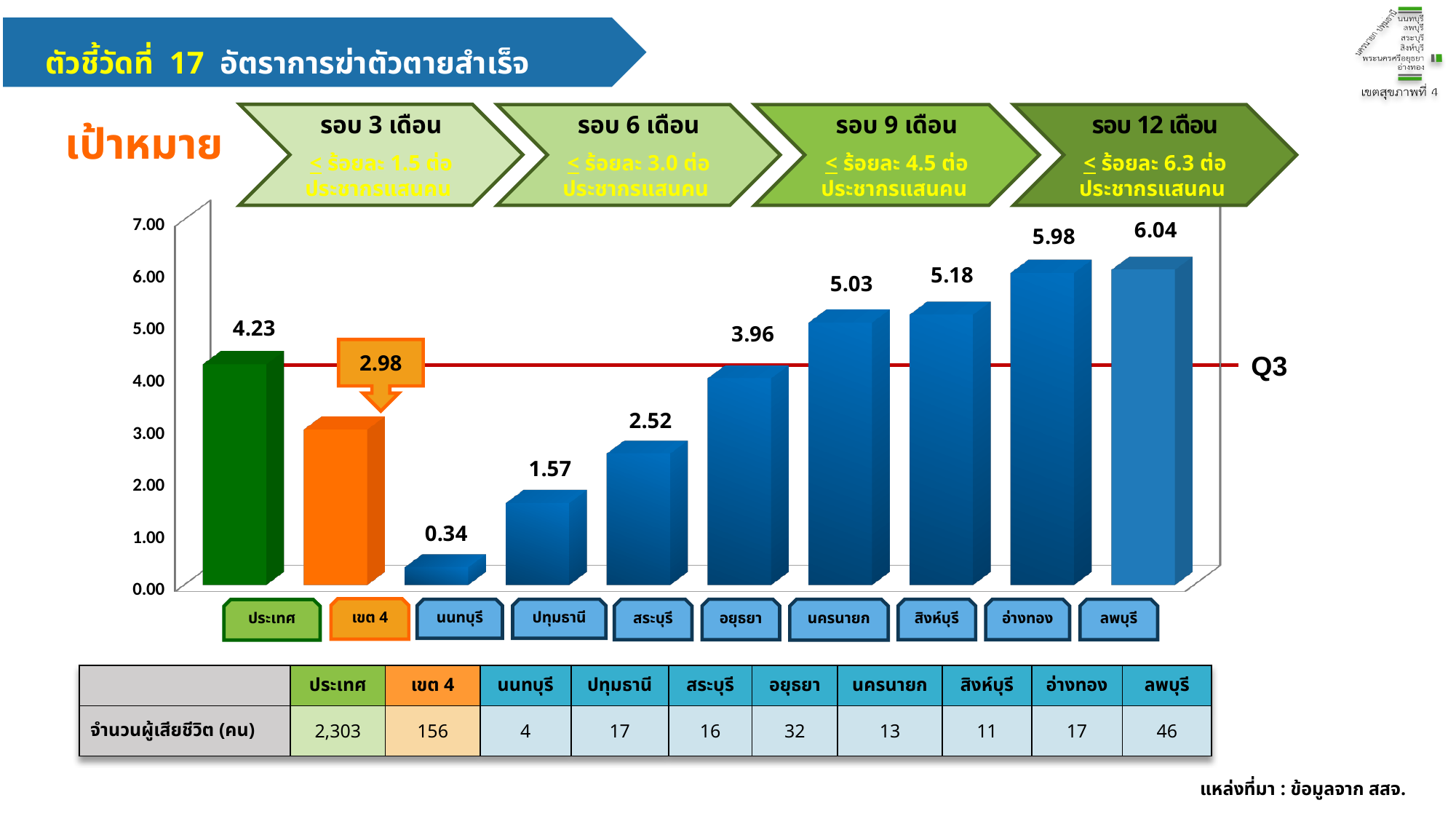
What label is shown at the right end of the red horizontal line on the chart? Q3 How many categories are shown on the x axis of the chart? 10 What is the difference between the values for ประเทศ and เขต 4? 1.25 What is the value for ลพบุรี? 6.04 What is the difference between the values for อ่างทอง and สิงห์บุรี? 0.80 Which category has the highest value? ลพบุรี Is the value for นครนายก greater or less than 4.00? greater What is the value for ประเทศ? 4.23 Which category has the lowest value? นนทบุรี Which is larger, the value for อยุธยา or the value for สระบุรี? อยุธยา What is the value for เขต 4? 2.98 What kind of chart is shown on the slide? bar chart